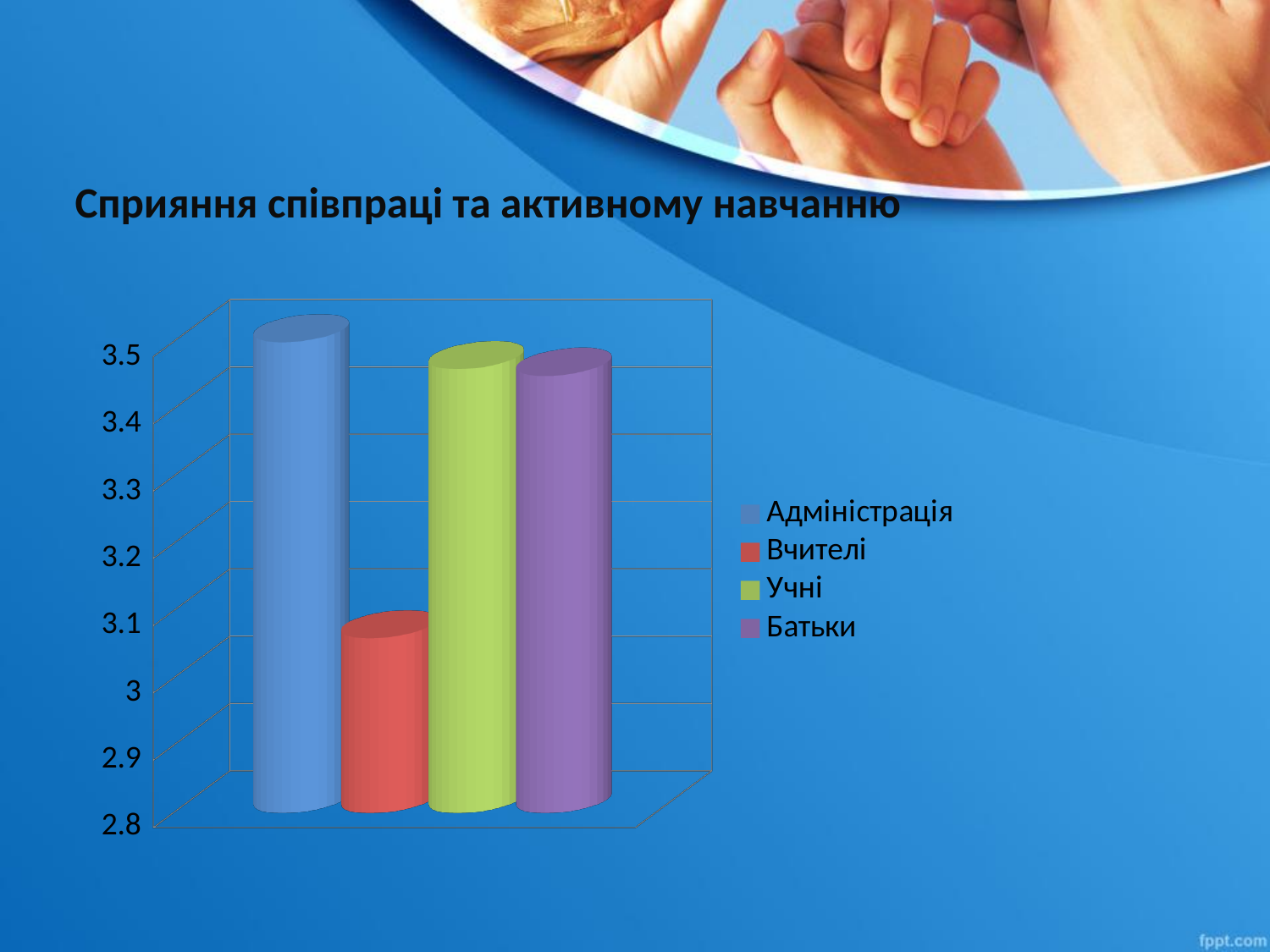
What colour is the bar for Вчителі? red Which series has the highest value? Адміністрація Is the value for Учні greater or less than 3.3? greater Is the value for Адміністрація greater or less than 3.4? greater Is the value for Батьки greater or less than 3.3? greater Which is larger, the value for Вчителі or the value for Учні? Учні What kind of chart is shown on the slide? bar chart How many series does the legend list? 4 Which is larger, the value for Адміністрація or the value for Вчителі? Адміністрація What is the title of the slide above the chart? Сприяння співпраці та активному навчанню Which series has the lowest value? Вчителі